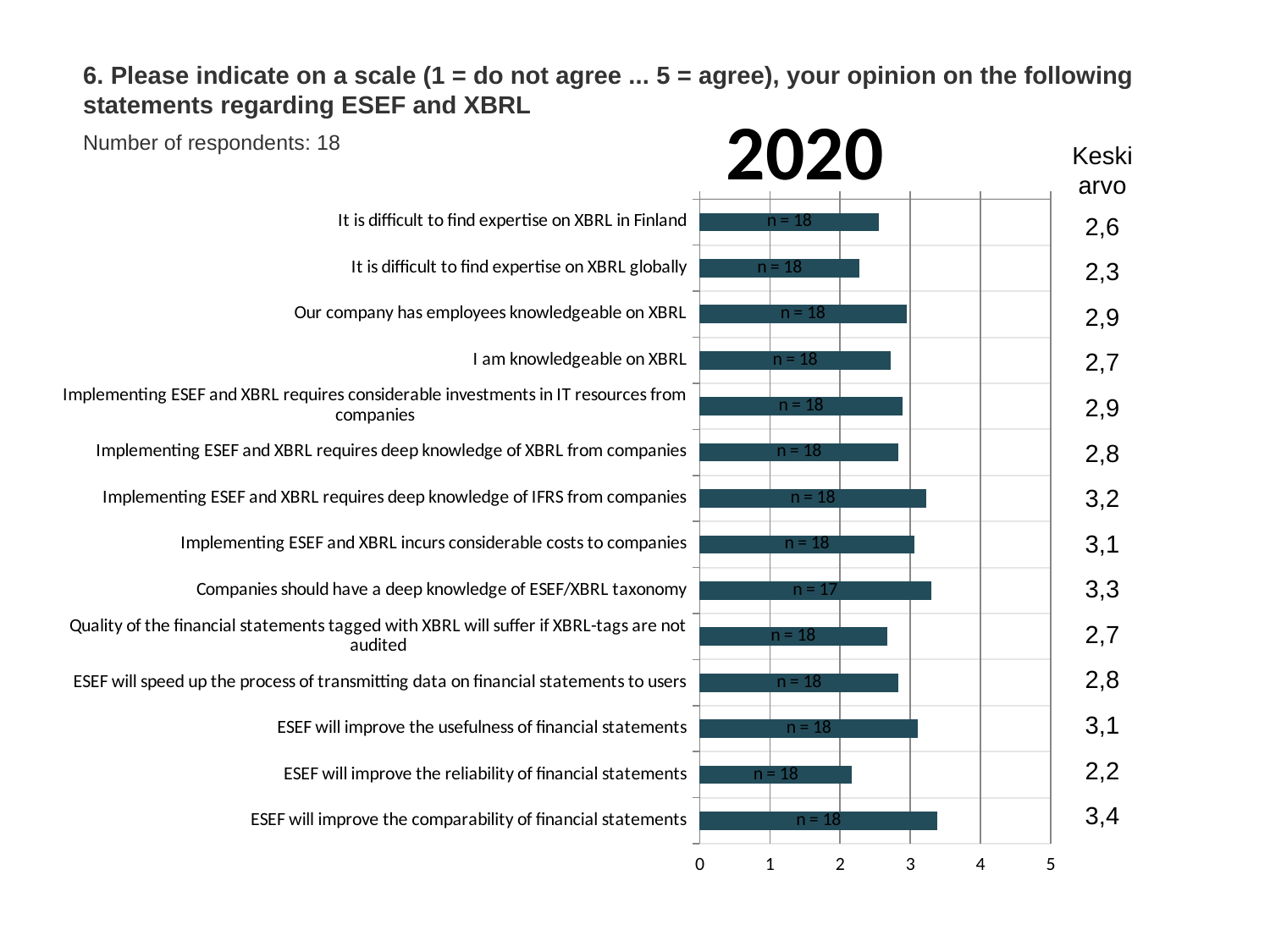
What is the n label shown on the bar for "Companies should have a deep knowledge of ESEF/XBRL taxonomy"? n = 17 What is the mean value (Keski arvo) for "Implementing ESEF and XBRL requires deep knowledge of IFRS from companies"? 3,2 What is the mean value (Keski arvo) for "It is difficult to find expertise on XBRL globally"? 2,3 What kind of chart is shown on the slide? Bar chart Which statement has the highest mean value? ESEF will improve the comparability of financial statements Which has a higher mean value: "Companies should have a deep knowledge of ESEF/XBRL taxonomy" or "I am knowledgeable on XBRL"? Companies should have a deep knowledge of ESEF/XBRL taxonomy Which statement has the lowest mean value? ESEF will improve the reliability of financial statements Is the value for "ESEF will improve the reliability of financial statements" greater or less than 3? less What is the difference between the mean values for "ESEF will improve the comparability of financial statements" and "ESEF will improve the reliability of financial statements"? 1,2 What is the mean value (Keski arvo) for "ESEF will improve the comparability of financial statements"? 3,4 How many statements (bars) are shown in the chart? 14 What is the title shown above the chart? 2020